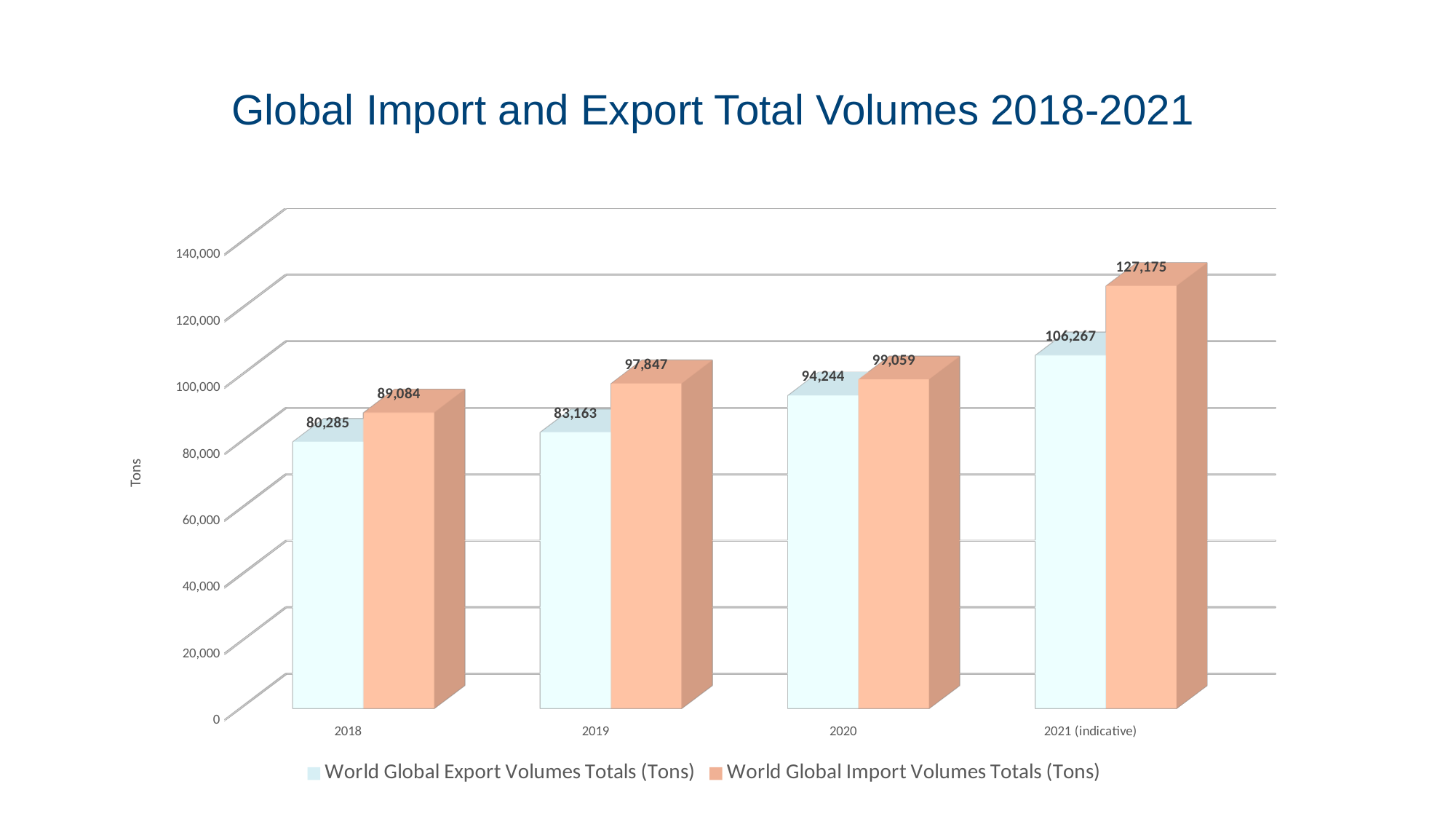
Is the World Global Import Volumes Totals (Tons) value for 2021 (indicative) greater or less than 120,000? greater What is the World Global Import Volumes Totals (Tons) value for 2021 (indicative)? 127,175 Which is larger in 2019: the export volume or the import volume? Import volume Do the World Global Export Volumes Totals (Tons) rise or fall from 2018 to 2021 (indicative)? Rise What kind of chart is shown on the slide? Bar chart How many series does the legend list? 2 What is the difference between the import and export volumes for 2020? 4,815 What is the World Global Export Volumes Totals (Tons) value for 2018? 80,285 What is the World Global Import Volumes Totals (Tons) value for 2019? 97,847 How many years are shown on the x axis? 4 Which year has the lowest World Global Import Volumes Totals (Tons)? 2018 Which year has the highest World Global Export Volumes Totals (Tons)? 2021 (indicative)